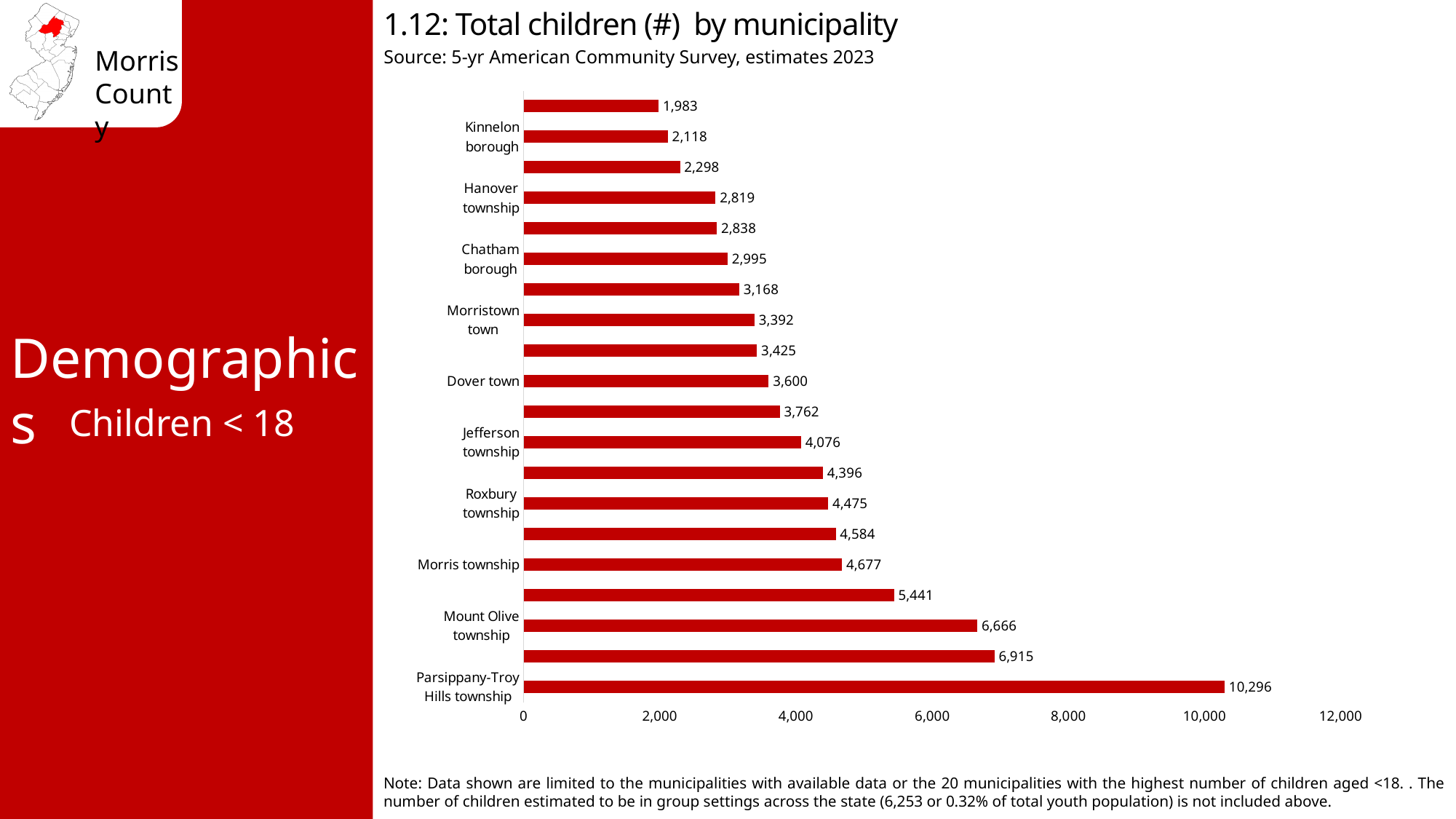
Which municipality has the highest number of children in the chart? Parsippany-Troy Hills township What is the total number of children for Mount Olive township? 6,666 What is the difference between the values for Parsippany-Troy Hills township and Mount Olive township? 3,630 What is the source cited for the chart data? 5-yr American Community Survey, estimates 2023 What is the total number of children for Dover town? 3,600 What is the total number of children for Kinnelon borough? 2,118 Is the value for Chatham borough greater or less than 4,000? less What is the total number of children for Parsippany-Troy Hills township? 10,296 What is the smallest value shown on any bar in the chart? 1,983 How many municipalities (bars) are plotted in the chart? 20 What type of chart is shown on the slide? bar chart Which has more children, Jefferson township or Dover town? Jefferson township